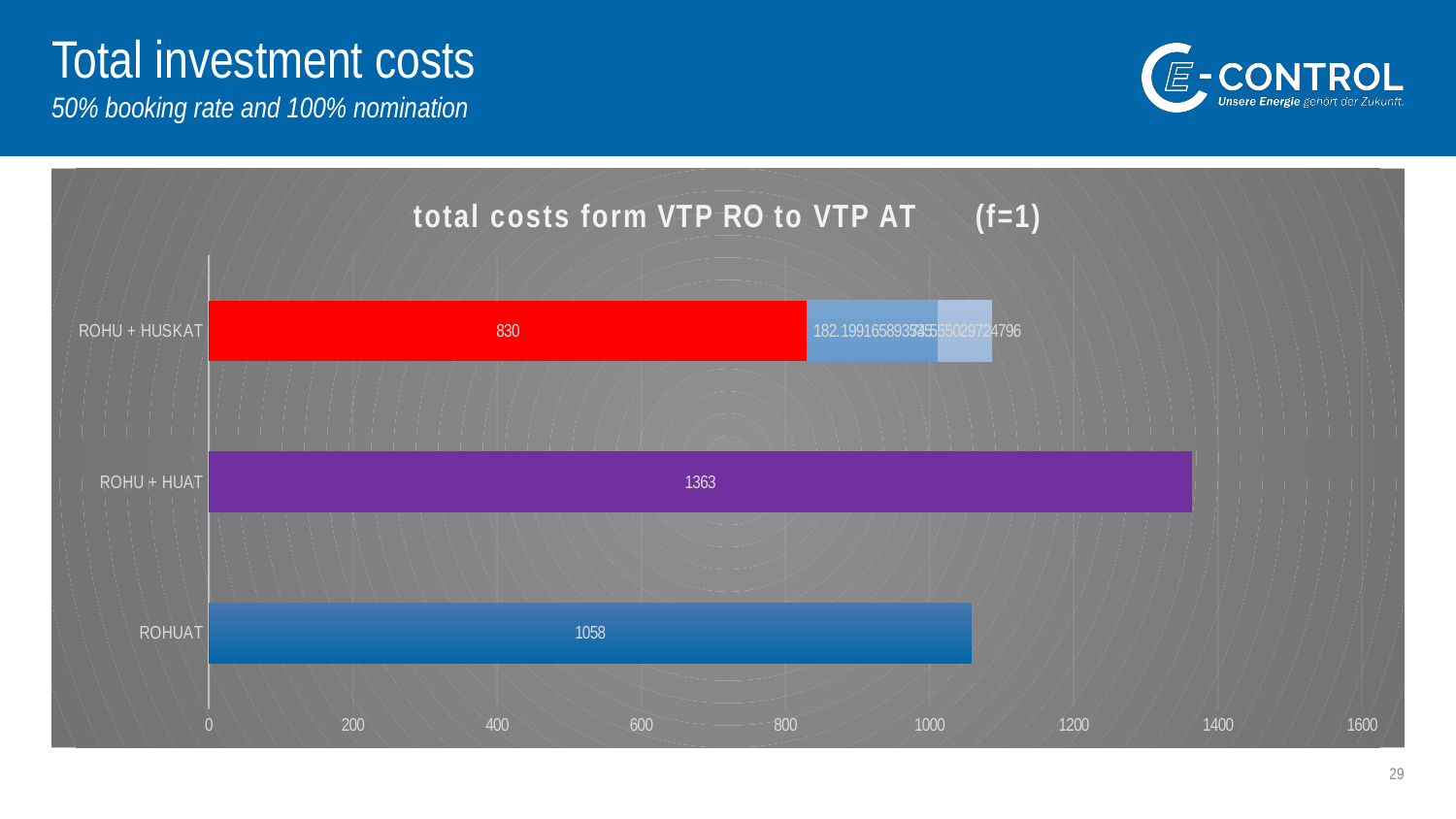
What is the value for ROHUAT? 1058 How many categories are shown on the chart? 3 What is the difference between the values for ROHU + HUAT and ROHUAT? 305 What is the title of the chart? total costs form VTP RO to VTP AT (f=1) Is the value for ROHU + HUAT greater or less than 1200? greater What is the value of the red segment of the ROHU + HUSKAT bar? 830 Is the total length of the ROHU + HUSKAT bar greater or less than 1000? greater Which category has the longest bar? ROHU + HUAT What kind of chart is shown on the slide? bar chart What is the value for ROHU + HUAT? 1363 Which is larger, the value for ROHU + HUAT or the value for ROHUAT? ROHU + HUAT What is the highest value shown on the horizontal axis? 1600